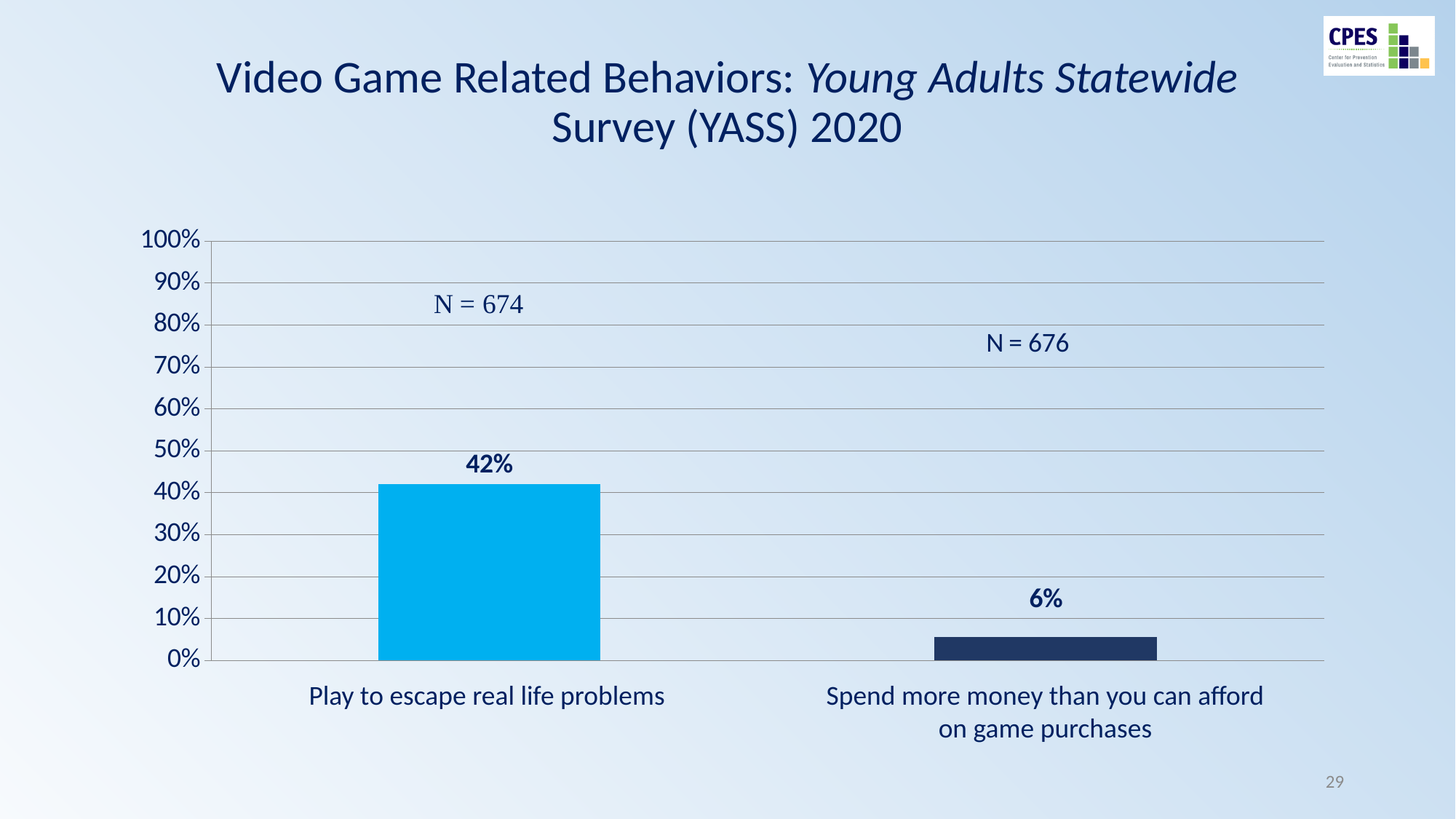
What is the sample size (N) shown for 'Spend more money than you can afford on game purchases'? N = 676 Is the value for 'Play to escape real life problems' greater or less than 50%? less What percentage of respondents reported playing video games to escape real life problems? 42% How many behavior categories are shown in the chart? 2 What is the sample size (N) shown for 'Play to escape real life problems'? N = 674 Which behavior has the highest percentage? Play to escape real life problems Which is larger: the percentage for 'Play to escape real life problems' or for 'Spend more money than you can afford on game purchases'? Play to escape real life problems What type of chart is shown on the slide? Bar chart Which behavior has the lowest percentage? Spend more money than you can afford on game purchases What percentage of respondents reported spending more money than they can afford on game purchases? 6% What is the difference in percentage points between 'Play to escape real life problems' and 'Spend more money than you can afford on game purchases'? 36 percentage points Is the value for 'Spend more money than you can afford on game purchases' greater or less than 10%? less